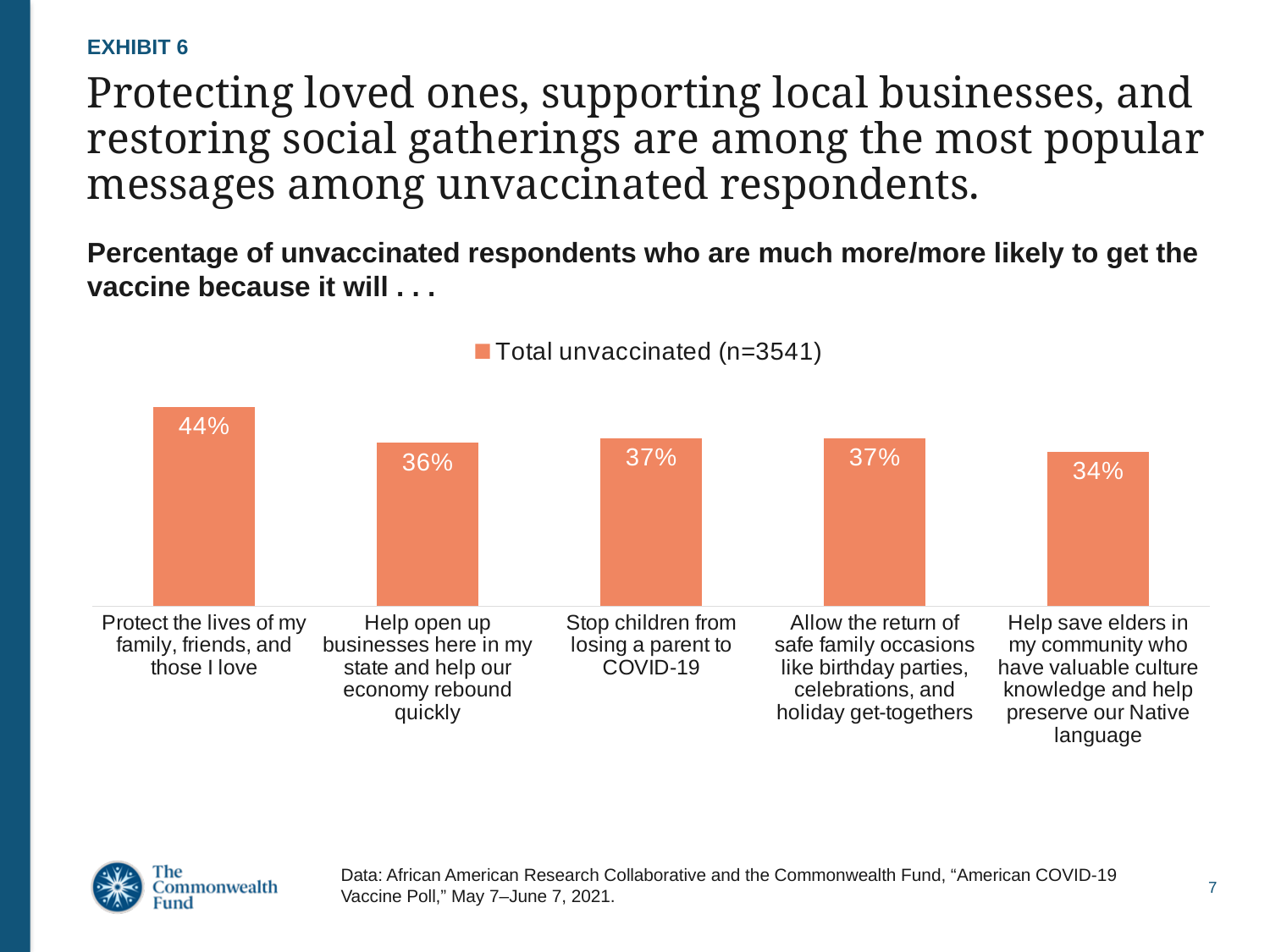
What percentage of unvaccinated respondents are more likely to get the vaccine because it will protect the lives of their family, friends, and those they love? 44% What is the sample size (n) given in the legend for total unvaccinated respondents? 3541 Which is larger: the value for 'Stop children from losing a parent to COVID-19' or the value for 'Help open up businesses here in my state...'? Stop children from losing a parent to COVID-19 How many series does the legend list? 1 Which message has the highest percentage of unvaccinated respondents saying they are more likely to get the vaccine? Protect the lives of my family, friends, and those I love What kind of chart is shown on the slide? Bar chart What is the value for 'Help open up businesses here in my state and help our economy rebound quickly'? 36% What is the difference in percentage points between 'Protect the lives of my family, friends, and those I love' and 'Help save elders in my community...'? 10 percentage points How many message categories are shown in the chart? 5 Which message has the lowest percentage? Help save elders in my community who have valuable culture knowledge and help preserve our Native language What is the value for 'Stop children from losing a parent to COVID-19'? 37% What is the value for 'Help save elders in my community who have valuable culture knowledge and help preserve our Native language'? 34%